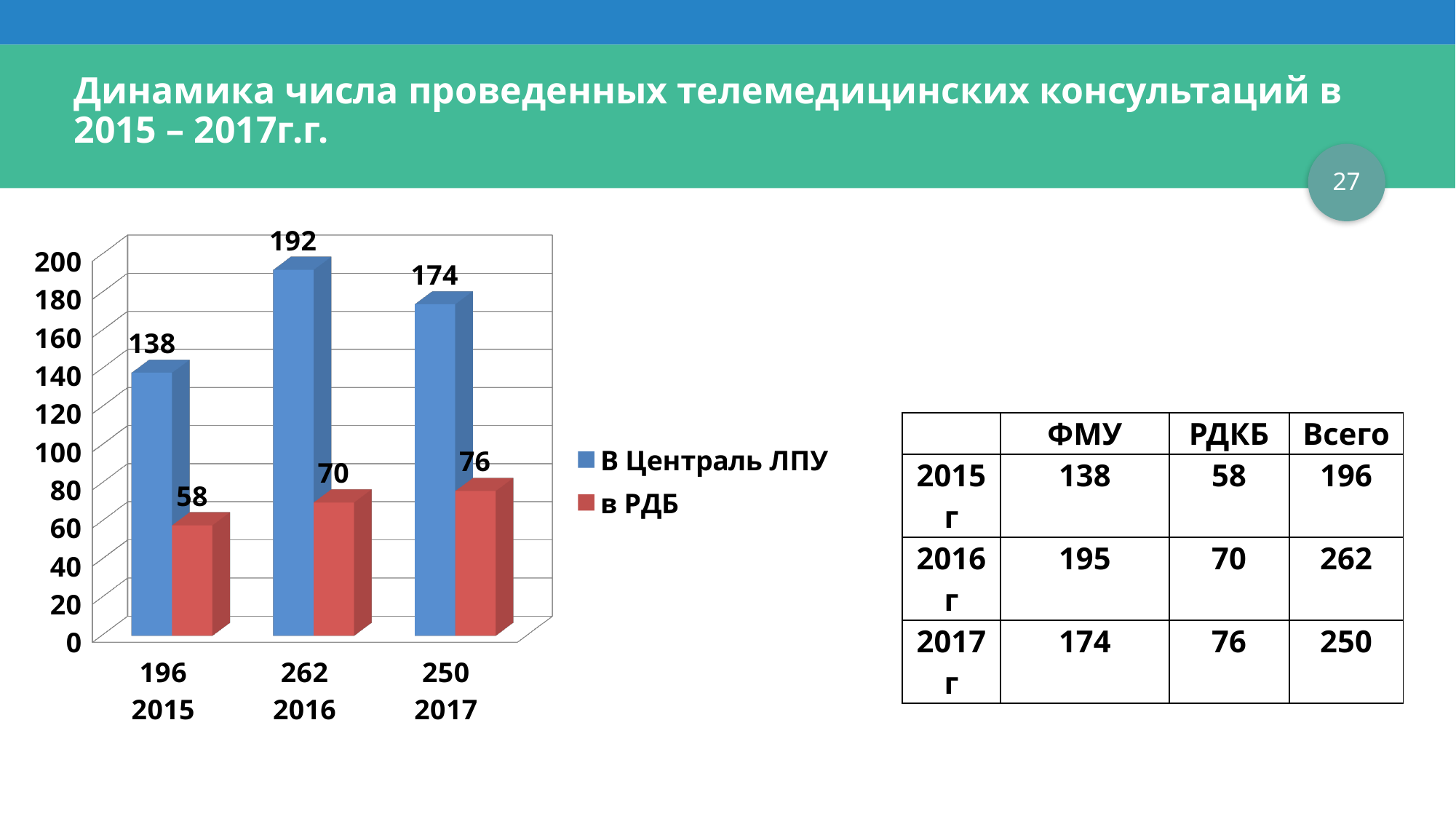
In which year is the "В Централь ЛПУ" value highest? 2016 What is the value for "в РДБ" in 2017? 76 What is the difference between the "В Централь ЛПУ" value and the "в РДБ" value in 2017? 98 How many year categories are plotted on the chart? 3 What type of chart is shown on the slide? bar chart What is the value for "В Централь ЛПУ" in 2016 according to the chart's data label? 192 Which colour represents the "в РДБ" series in the chart? red What is the value for "В Централь ЛПУ" in 2015? 138 Which is larger: the "в РДБ" value in 2016 or in 2017? 2017 In which year is the "в РДБ" value lowest? 2015 Does the "в РДБ" value rise or fall from 2015 to 2017? rise How many series does the chart legend list? 2